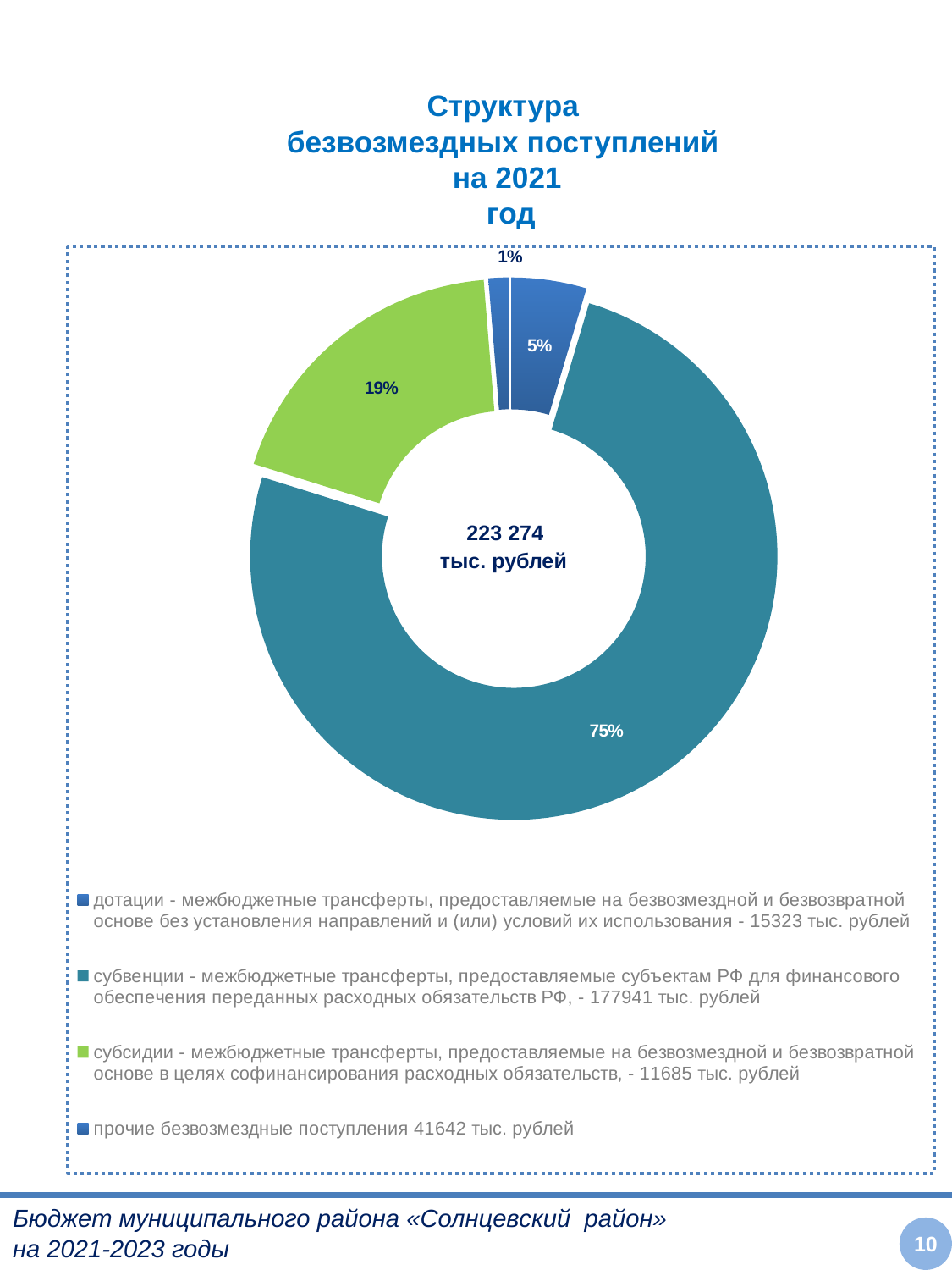
How many slices does the doughnut chart have? 4 What percentage is shown on the dark blue slice (дотации)? 5% How many entries does the legend list? 4 What percentage is shown on the green slice (субсидии)? 19% What kind of chart is shown on the slide? Doughnut (pie) chart Which slice is larger, the green one (19%) or the dark blue one (5%)? The green one (19%) What total value is printed in the centre of the doughnut chart? 223 274 тыс. рублей According to the legend, what amount is given for субвенции? 177941 тыс. рублей What is the difference in percentage points between the 75% slice and the 19% slice? 56 What percentage is shown on the smallest slice of the chart? 1% Which category has the largest share of the chart? субвенции What percentage is shown on the largest slice of the chart? 75%